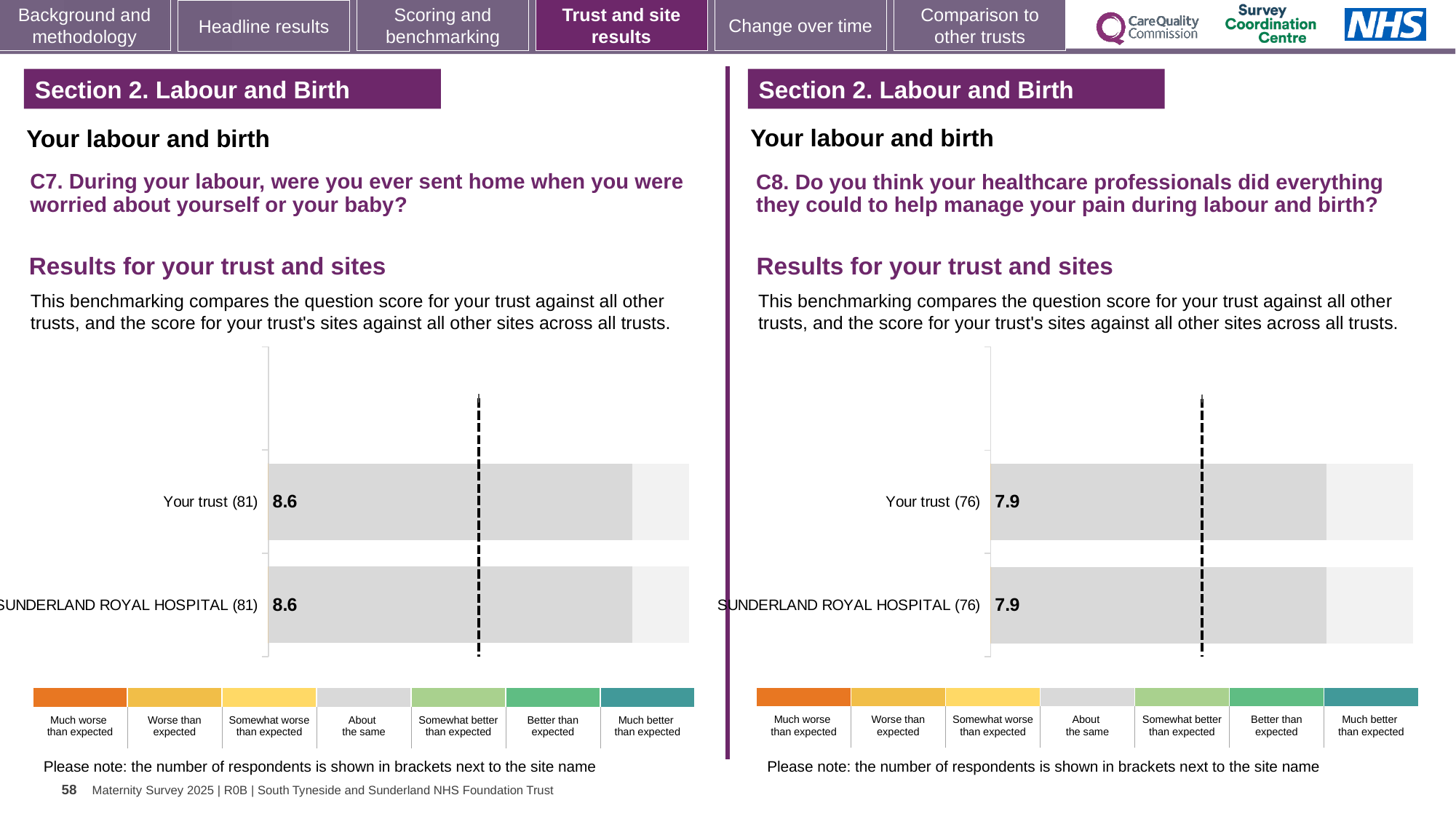
In the C8 chart on the right, what is the score for SUNDERLAND ROYAL HOSPITAL? 7.9 In the C8 chart on the right, what is the score for Your trust? 7.9 In the C8 chart on the right, how many respondents are shown in brackets for SUNDERLAND ROYAL HOSPITAL? 76 In the C7 chart on the left, what is the score for SUNDERLAND ROYAL HOSPITAL? 8.6 What kind of chart is used for the C7 results on the left? Bar chart In the C7 chart on the left, how many respondents are shown in brackets for Your trust? 81 How many bars are plotted in the C7 chart on the left? 2 What is the difference between the Your trust score in the C7 chart and the Your trust score in the C8 chart? 0.7 How many bars are plotted in the C8 chart on the right? 2 In the C8 chart on the right, is the score for SUNDERLAND ROYAL HOSPITAL the same as the score for Your trust? Yes Is the Your trust score in the C7 chart on the left larger or smaller than the Your trust score in the C8 chart on the right? Larger In the C7 chart on the left, what is the score for Your trust? 8.6